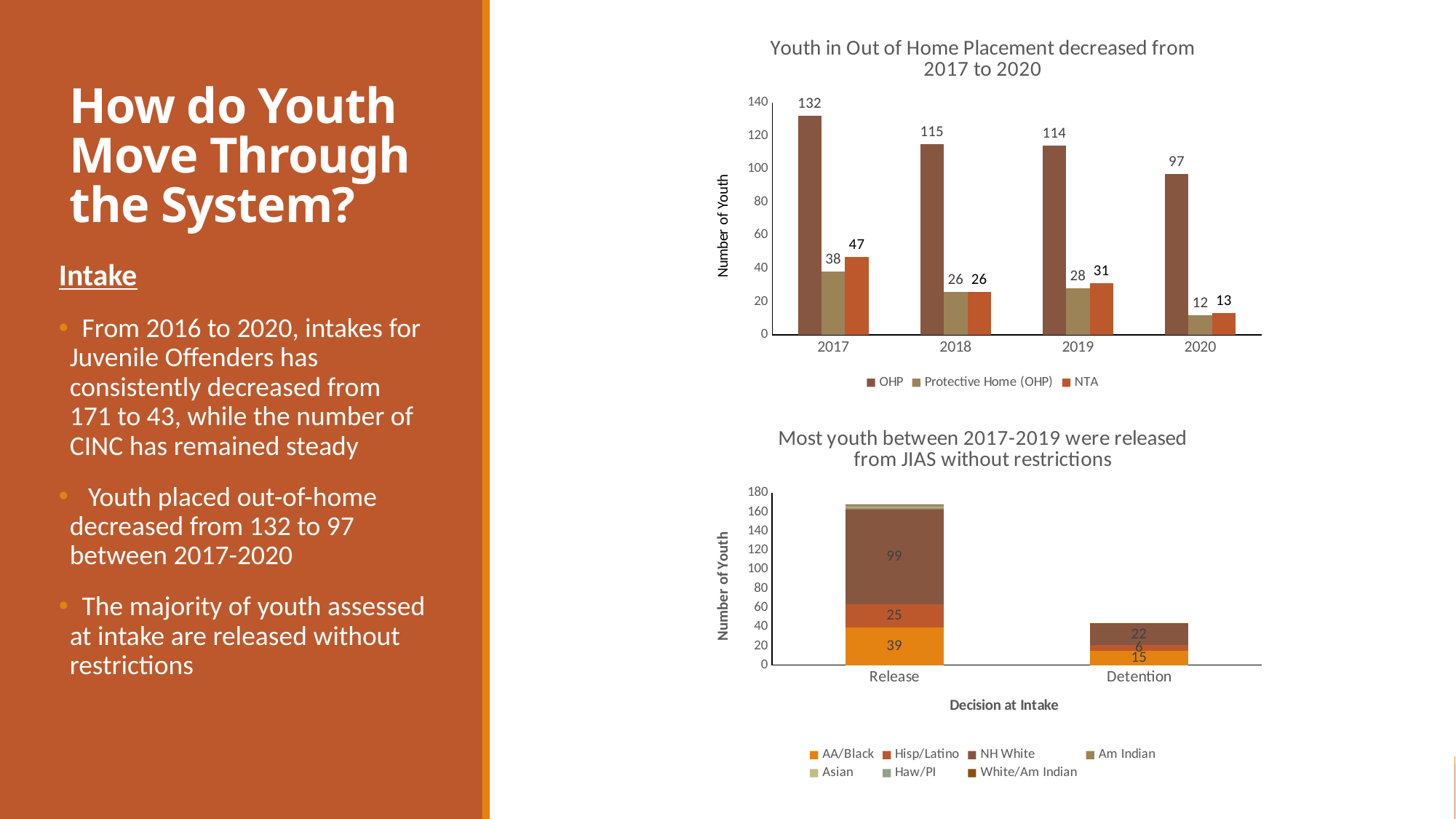
In the chart titled "Youth in Out of Home Placement decreased from 2017 to 2020", how many series does the legend list? 3 In the chart titled "Most youth between 2017-2019 were released from JIAS without restrictions", what is the AA/Black value for Detention? 15 In the chart titled "Youth in Out of Home Placement decreased from 2017 to 2020", what is the OHP value for 2017? 132 In the chart titled "Youth in Out of Home Placement decreased from 2017 to 2020", what is the difference between the OHP values for 2017 and 2020? 35 In the chart titled "Youth in Out of Home Placement decreased from 2017 to 2020", what is the NTA value for 2019? 31 In the chart titled "Youth in Out of Home Placement decreased from 2017 to 2020", how many years are shown on the x axis? 4 In the chart titled "Youth in Out of Home Placement decreased from 2017 to 2020", what is the Protective Home (OHP) value for 2020? 12 In the chart titled "Most youth between 2017-2019 were released from JIAS without restrictions", which is larger, the Hisp/Latino value for Release or for Detention? Release In the chart titled "Youth in Out of Home Placement decreased from 2017 to 2020", does the OHP series rise or fall from 2017 to 2020? fall In the chart titled "Most youth between 2017-2019 were released from JIAS without restrictions", what kind of chart is shown? stacked bar chart In the chart titled "Most youth between 2017-2019 were released from JIAS without restrictions", what is the NH White value for Release? 99 In the chart titled "Youth in Out of Home Placement decreased from 2017 to 2020", which year has the lowest OHP value? 2020